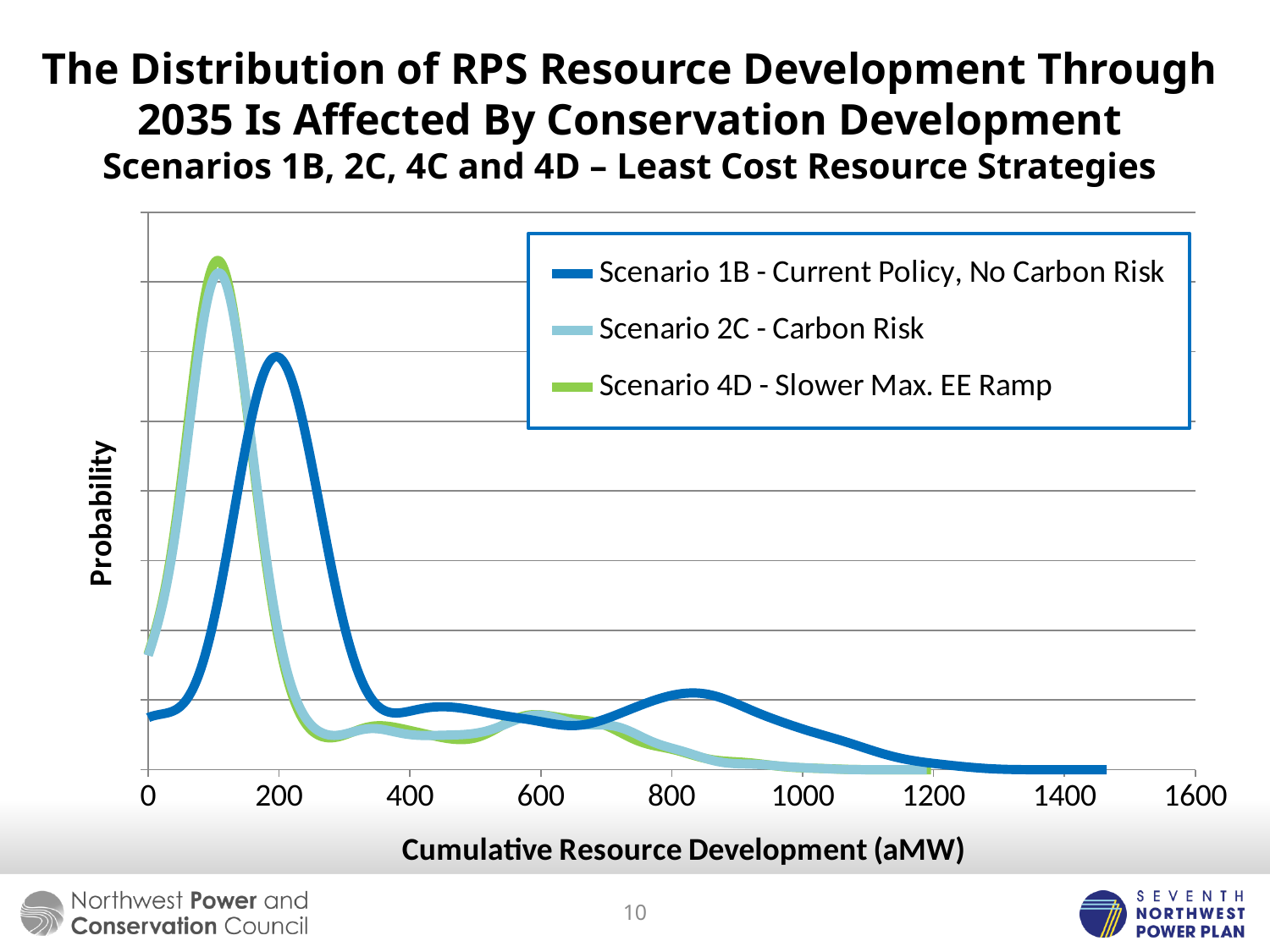
Which scenario's curve extends furthest to the right along the x axis? Scenario 1B - Current Policy, No Carbon Risk What is the largest value labelled on the x axis? 1600 Is the peak of Scenario 1B higher or lower than the peak of Scenario 2C? lower How many tick labels are shown on the x axis? 9 What kind of chart is shown on the slide? line chart Which scenario has the lowest peak probability? Scenario 1B - Current Policy, No Carbon Risk Does the peak of Scenario 1B occur at a higher or lower cumulative resource development than the peak of Scenario 2C? higher Does the peak of Scenario 4D occur at a cumulative resource development greater or less than 200 aMW? less Does the Scenario 1B curve rise or fall between 200 and 400 aMW? fall How many series does the legend list? 3 What is the title of the y axis? Probability What is the title of the x axis? Cumulative Resource Development (aMW)